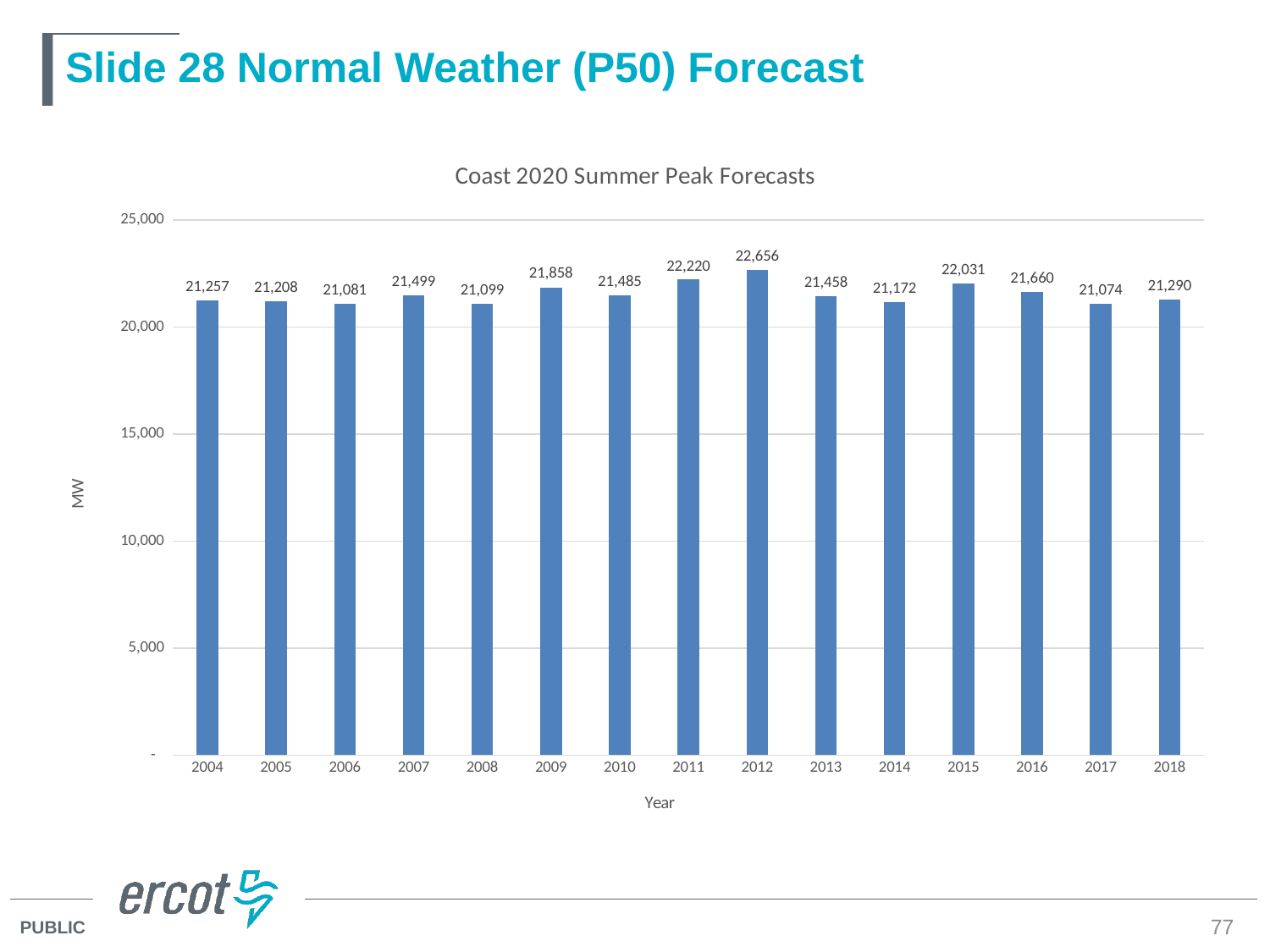
What kind of chart is the Coast 2020 Summer Peak Forecasts chart? bar chart Which year has the lowest value in the Coast 2020 Summer Peak Forecasts chart? 2017 What is the value for 2015 in the Coast 2020 Summer Peak Forecasts chart? 22,031 What is the difference between the values for 2015 and 2014 in the Coast 2020 Summer Peak Forecasts chart? 859 What is the label on the vertical axis of the Coast 2020 Summer Peak Forecasts chart? MW What is the difference between the values for 2012 and 2011 in the Coast 2020 Summer Peak Forecasts chart? 436 How many years are shown in the Coast 2020 Summer Peak Forecasts chart? 15 Which year has the highest value in the Coast 2020 Summer Peak Forecasts chart? 2012 What is the value for 2004 in the Coast 2020 Summer Peak Forecasts chart? 21,257 Is the value for 2012 in the Coast 2020 Summer Peak Forecasts chart greater or less than 20,000? greater What is the value for 2012 in the Coast 2020 Summer Peak Forecasts chart? 22,656 Which is larger in the Coast 2020 Summer Peak Forecasts chart, the value for 2009 or the value for 2010? 2009